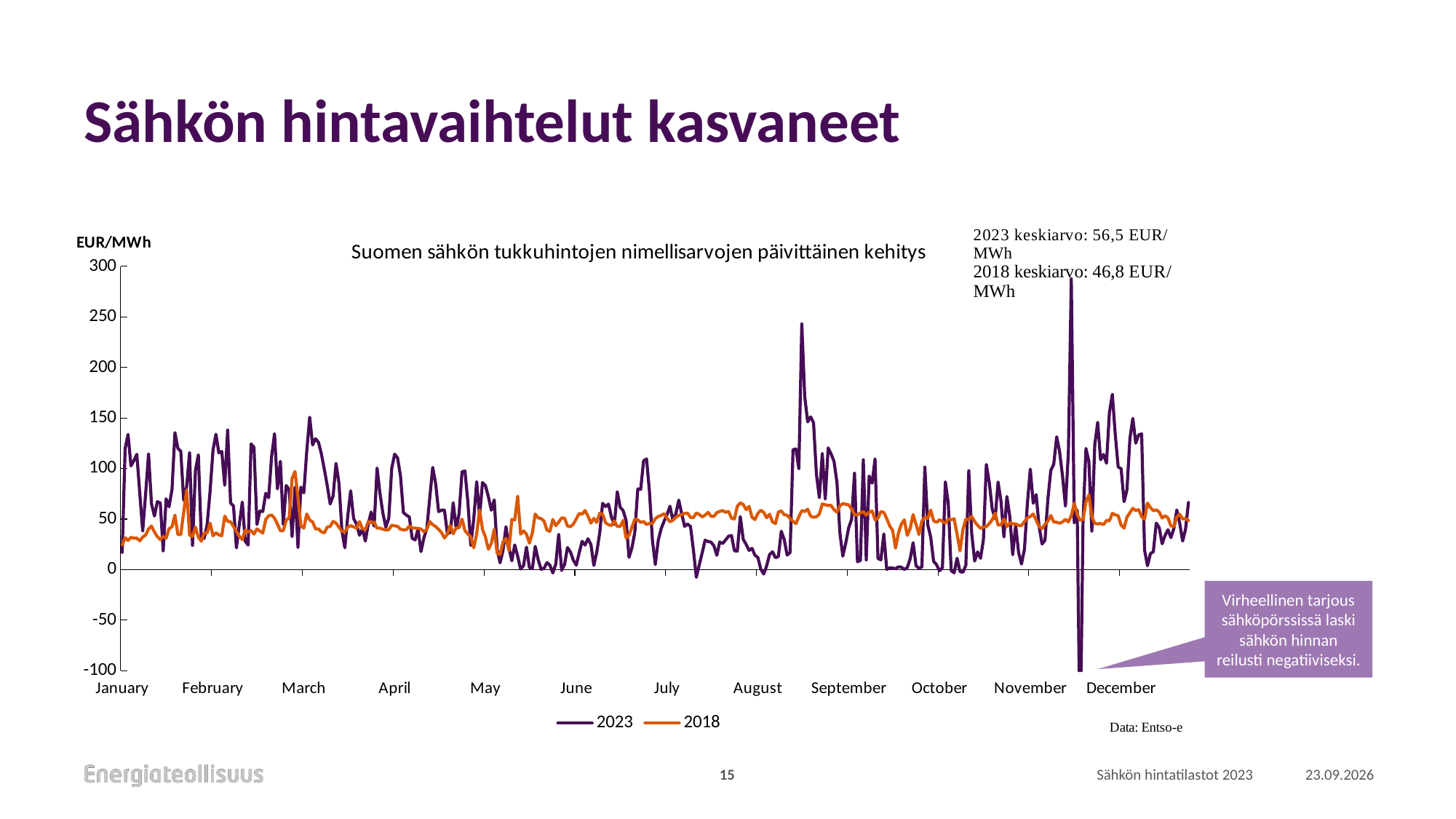
Is the lowest 2023 value, the dip in late November, greater or less than -50 EUR/MWh? less How many series does the chart legend list? 2 What is the title of the chart? Suomen sähkön tukkuhintojen nimellisarvojen päivittäinen kehitys Which two years are shown in the chart legend? 2023 and 2018 How many months are labelled on the x axis? 12 What kind of chart is shown on the slide? line chart According to the text on the chart, what is the 2023 average price (keskiarvo)? 56,5 EUR/MWh What is the difference between the 2023 average and the 2018 average shown on the chart? 9,7 EUR/MWh Is the highest 2023 value, the spike in late November, greater or less than 250 EUR/MWh? greater According to the text on the chart, what is the 2018 average price (keskiarvo)? 46,8 EUR/MWh Which year has the higher average price according to the text on the chart, 2023 or 2018? 2023 Is the 2018 value in August greater or less than 100 EUR/MWh? less